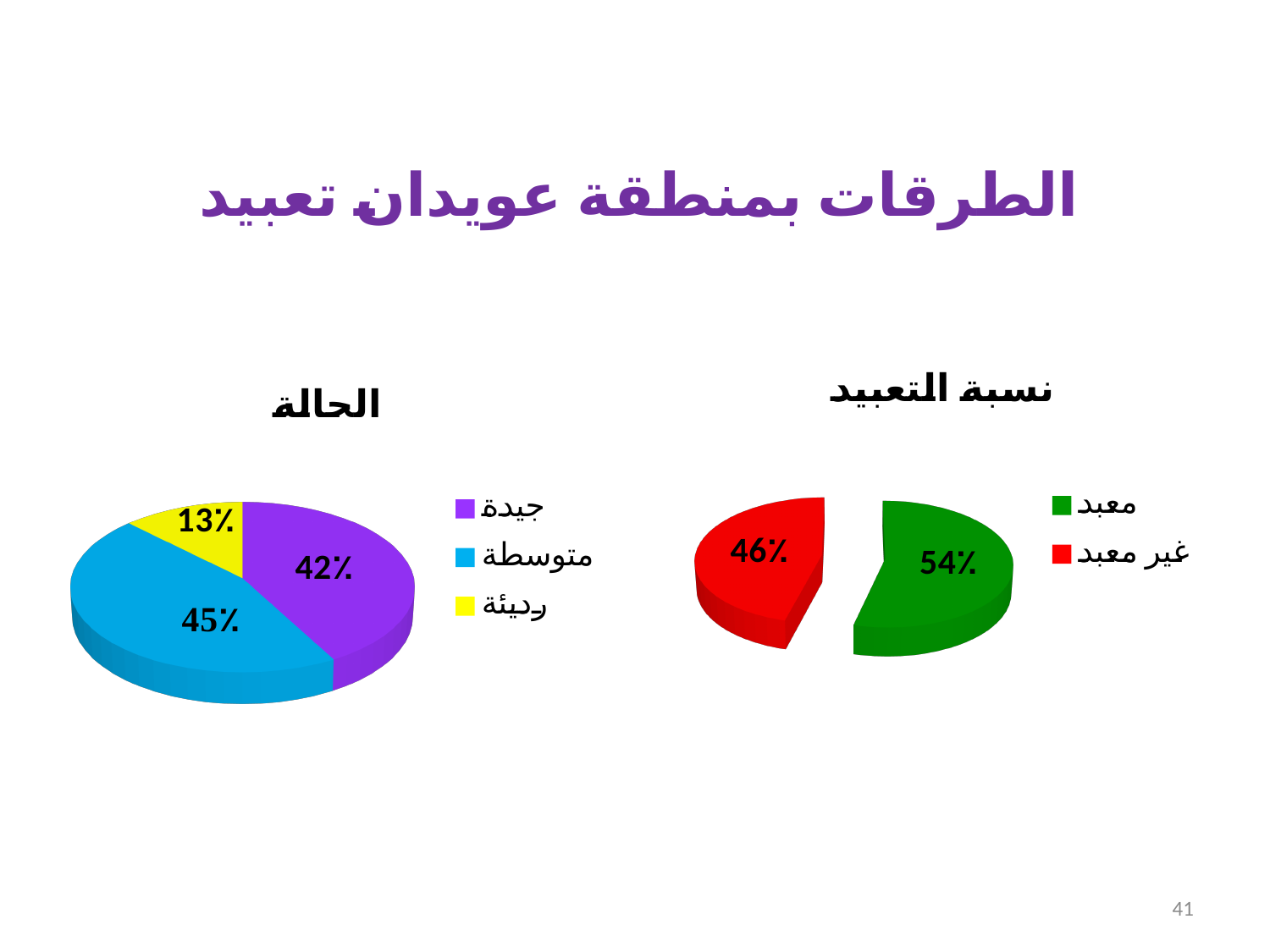
In the chart titled "نسبة التعبيد", what is the difference in percentage points between "معبد" and "غير معبد"? 8 In the chart titled "الحالة", which category has the largest slice? متوسطة In the chart titled "نسبة التعبيد", what percentage is shown for "معبد"? 54% In the chart titled "نسبة التعبيد", what percentage is shown for "غير معبد"? 46% In the chart titled "الحالة", which category has the smallest slice? رديئة In the chart titled "الحالة", what percentage is shown for "رديئة"? 13% In the chart titled "الحالة", what percentage is shown for "متوسطة"? 45% In the chart titled "الحالة", which colour represents "جيدة"? Purple In the chart titled "الحالة", how many categories does the legend list? 3 In the chart titled "نسبة التعبيد", which category has the larger slice? معبد What type of chart is the chart titled "نسبة التعبيد"? Pie chart In the chart titled "الحالة", what percentage is shown for "جيدة"? 42%